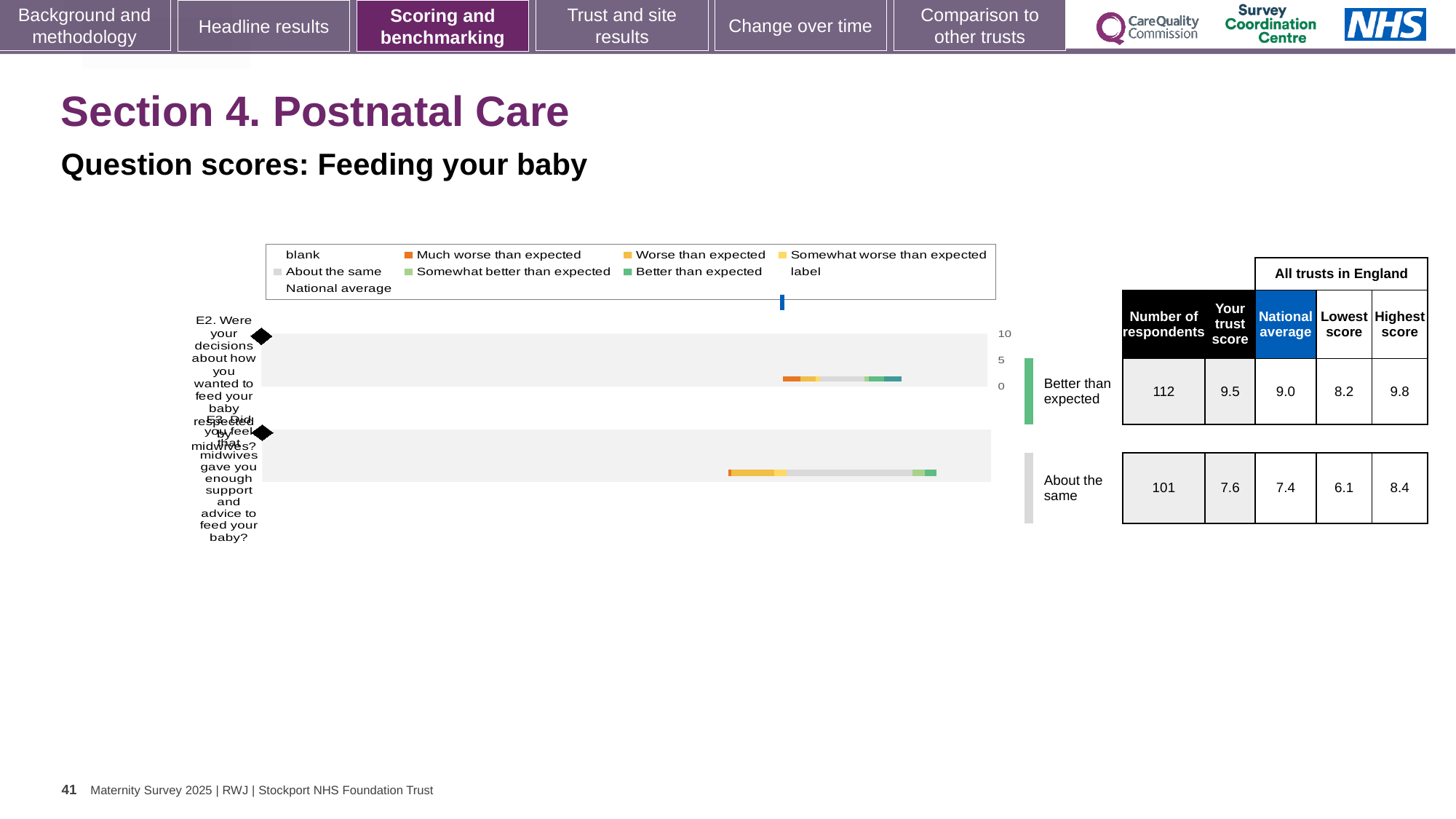
What is the national average for question E2? 9.0 What benchmark category is shown for question E2? Better than expected What is the difference between the trust score and the national average for question E3? 0.2 Which question has the higher trust score, E2 or E3? E2 What is the difference between the highest and lowest scores for question E3? 2.3 How many respondents answered question E3 (midwives gave enough support and advice to feed your baby)? 101 What is the lowest score among all trusts in England for question E3? 6.1 What is the trust score for question E2 (decisions about how you wanted to feed your baby respected by midwives)? 9.5 Is the trust score for question E2 larger or smaller than its national average? larger What kind of chart is used to show the question scores for Feeding your baby? bar chart What is the highest score among all trusts in England for question E2? 9.8 How many questions are plotted in the Feeding your baby chart? 2